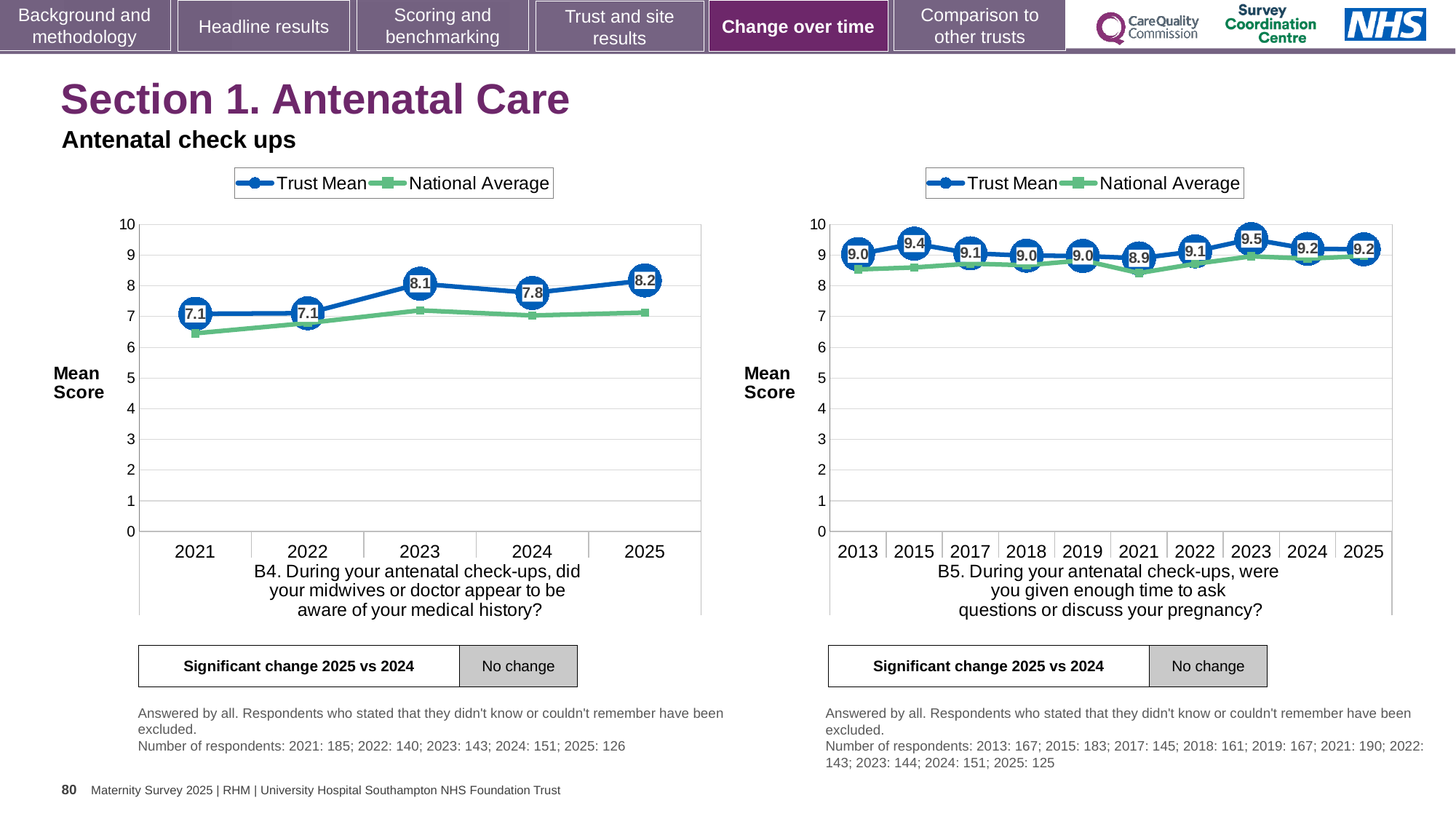
In the right chart (B5), how many years are shown on the x axis? 10 In the left chart (B4), what is the difference between the Trust Mean in 2025 and in 2021? 1.1 In the right chart (B5), which year has the lowest Trust Mean? 2021 In the right chart (B5), what is the Trust Mean value for 2021? 8.9 In the left chart (B4), is the National Average value for 2021 greater or less than 7? less In the left chart (B4), what is the Trust Mean value for 2023? 8.1 In the left chart (B4), how many years are shown on the x axis? 5 In the left chart (B4), what is the Trust Mean value for 2025? 8.2 In the left chart (B4), which year has the highest Trust Mean? 2025 In the right chart (B5), which is larger, the Trust Mean in 2015 or in 2017? 2015 In the right chart (B5), what is the Trust Mean value for 2023? 9.5 How many series does the legend of the right chart (B5) list? 2